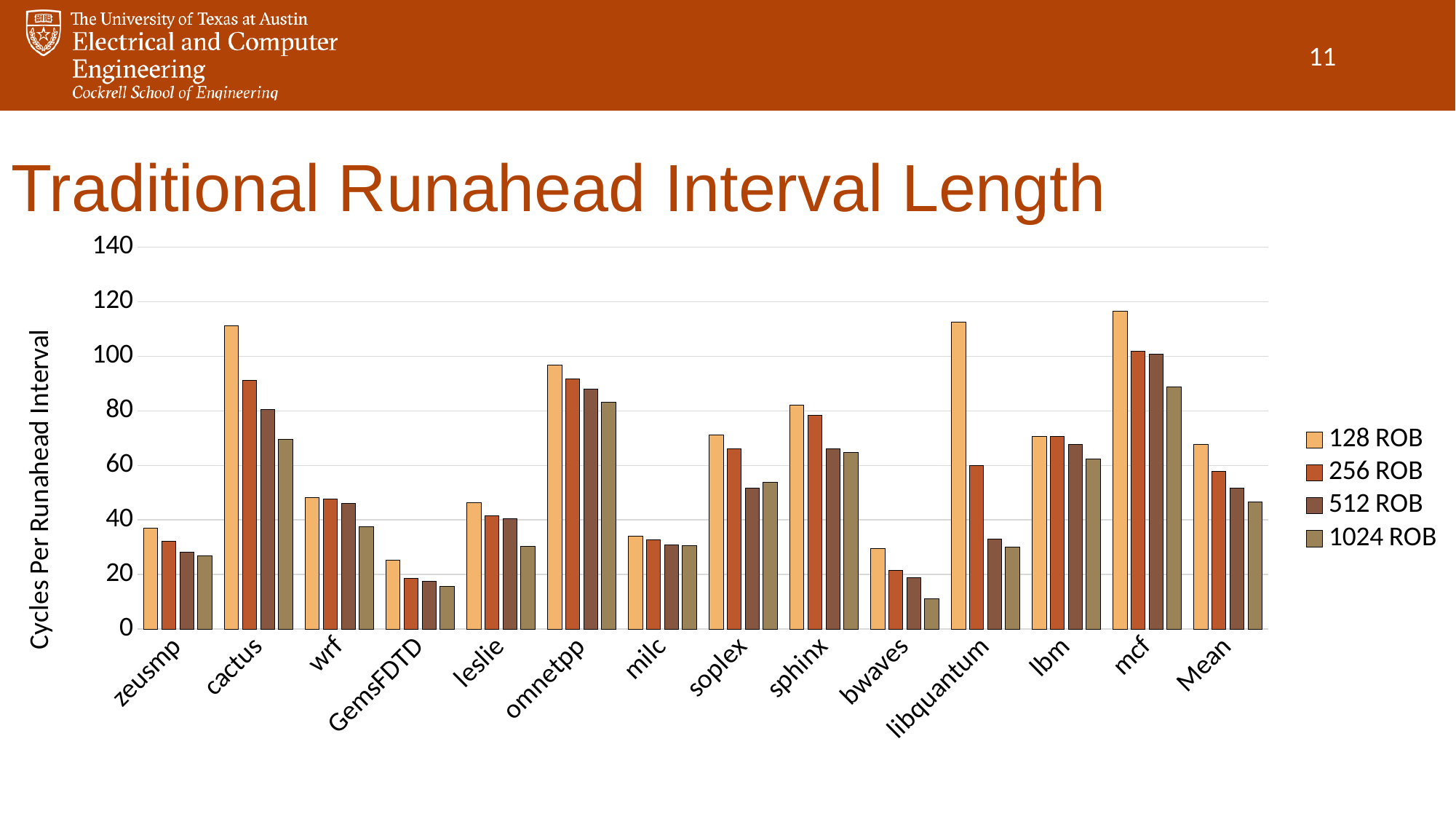
Which is larger, the 1024 ROB value for mcf or the 1024 ROB value for lbm? mcf Which category has the lowest 1024 ROB value? bwaves Is the 128 ROB value for omnetpp greater or less than 80? greater For cactus, do the values rise or fall going from 128 ROB to 1024 ROB? fall How many series does the legend list? 4 Which series is listed last in the legend? 1024 ROB Is the 1024 ROB value for bwaves greater or less than 20? less How many categories are shown along the x axis? 14 What kind of chart is shown on the slide? bar chart Is the 512 ROB value for libquantum greater or less than 40? less What is the label of the y axis? Cycles Per Runahead Interval